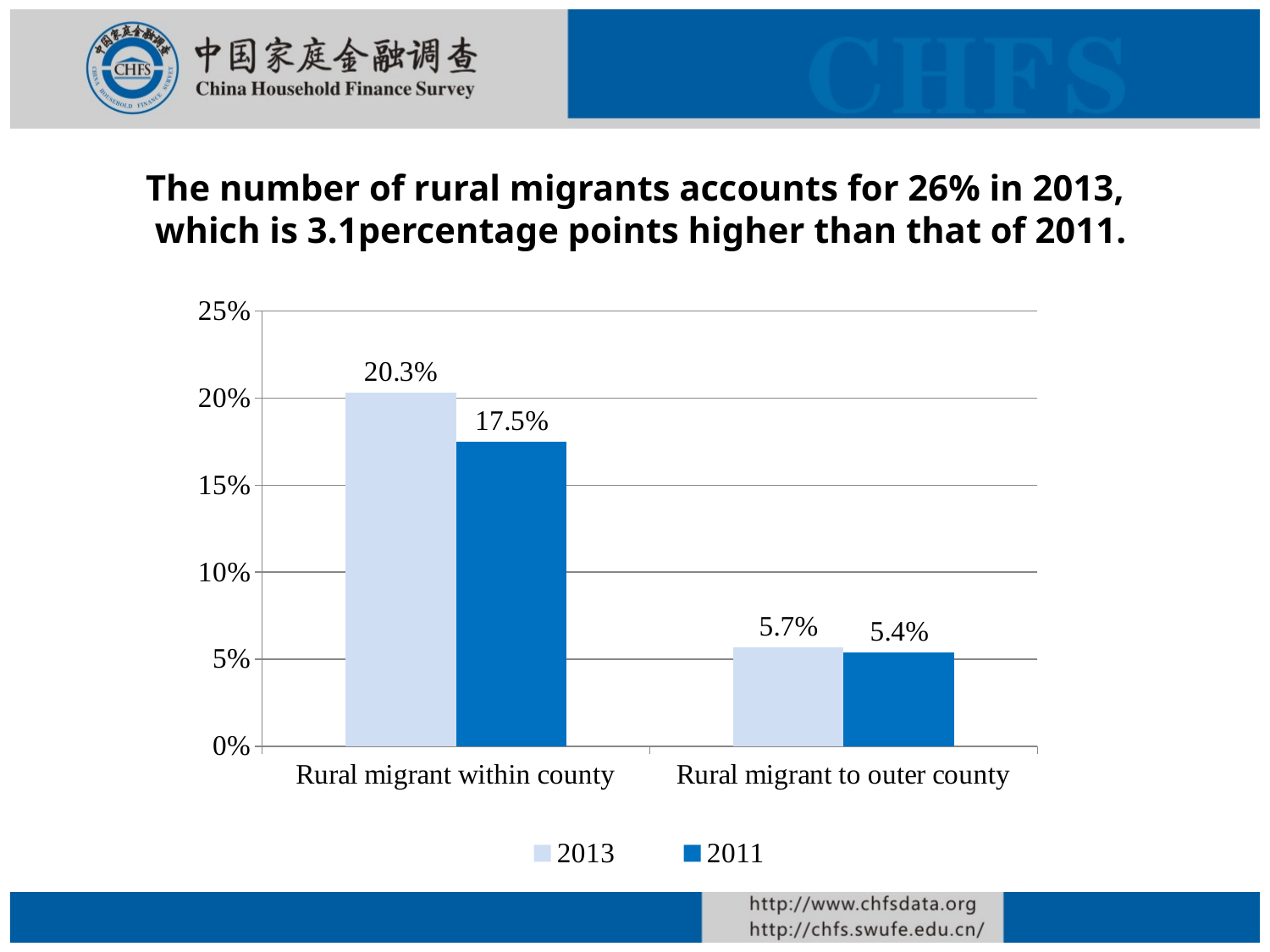
Which category has the highest value in the 2013 series? Rural migrant within county What is the difference between the 2013 and 2011 values for Rural migrant within county? 2.8 percentage points Is the 2011 value for Rural migrant within county greater or less than 15%? greater Which series is shown in the darker blue colour? 2011 Which is larger for Rural migrant to outer county: the 2013 value or the 2011 value? 2013 Which category has the lowest value in the 2011 series? Rural migrant to outer county What is the value for Rural migrant within county in 2013? 20.3% What is the value for Rural migrant to outer county in 2011? 5.4% What is the value for Rural migrant within county in 2011? 17.5% How many categories are shown on the x axis? 2 How many series does the legend list? 2 What kind of chart is shown on the slide? Bar chart